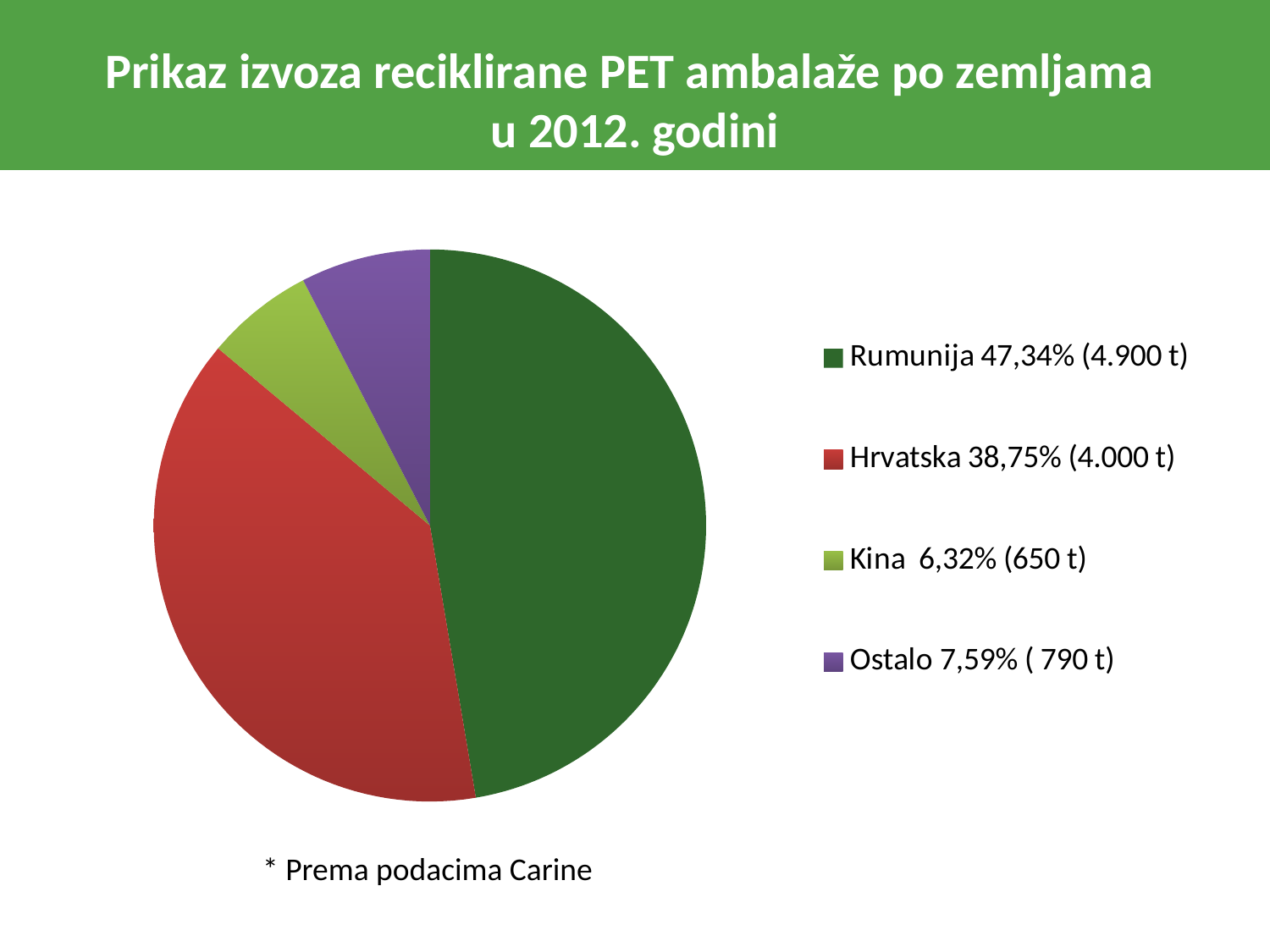
What is the title of the slide containing the pie chart? Prikaz izvoza reciklirane PET ambalaže po zemljama u 2012. godini What share of the pie does Rumunija account for? 47,34% Which country has the largest slice of the pie? Rumunija How many tonnes are shown for Rumunija in the legend? 4.900 t What share of the pie does Hrvatska account for? 38,75% Which category has the smallest slice of the pie? Kina How many tonnes are shown for Ostalo in the legend? 790 t How many slices does the pie chart have? 4 What is the difference in tonnes between Rumunija (4.900 t) and Hrvatska (4.000 t)? 900 t What share of the pie does Kina account for? 6,32% What kind of chart is shown on the slide? pie chart Which is larger, the slice for Ostalo or the slice for Kina? Ostalo